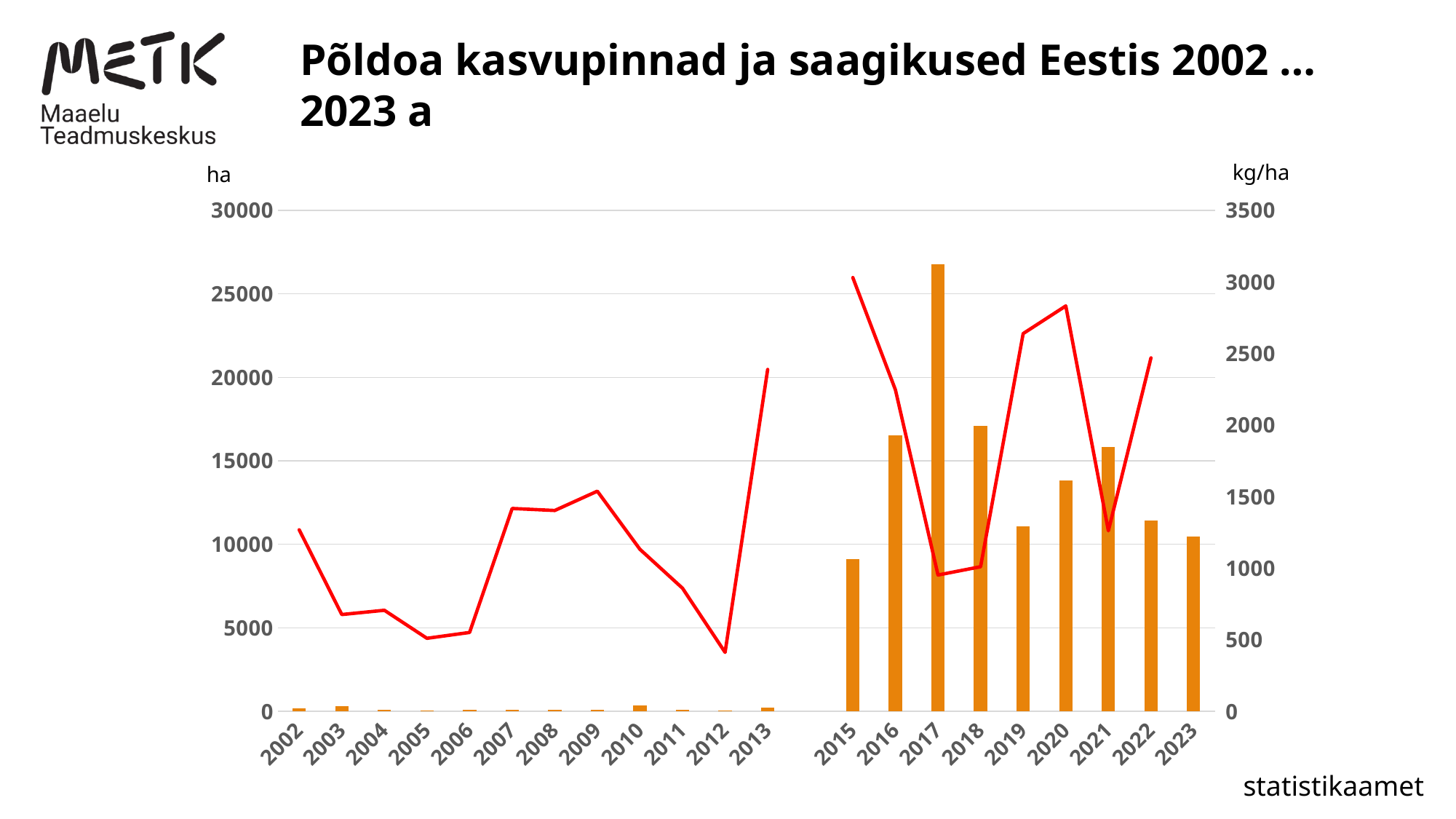
Does the red line rise or fall from 2002 to 2005? fall Which year has the taller bar, 2019 or 2020? 2020 Is the red line value (kg/ha) for 2013 greater or less than 2000? greater Which year has the tallest bar (largest area in ha)? 2017 What unit is shown on the right-hand axis? kg/ha In which year does the red line (kg/ha) reach its lowest point? 2012 What kind of chart is shown on the slide? A combined bar and line chart Is the bar value (ha) for 2020 greater or less than 15000? less Is the bar value (ha) for 2017 greater or less than 25000? greater How many years are shown on the x axis? 21 In which year does the red line (kg/ha) reach its highest point? 2015